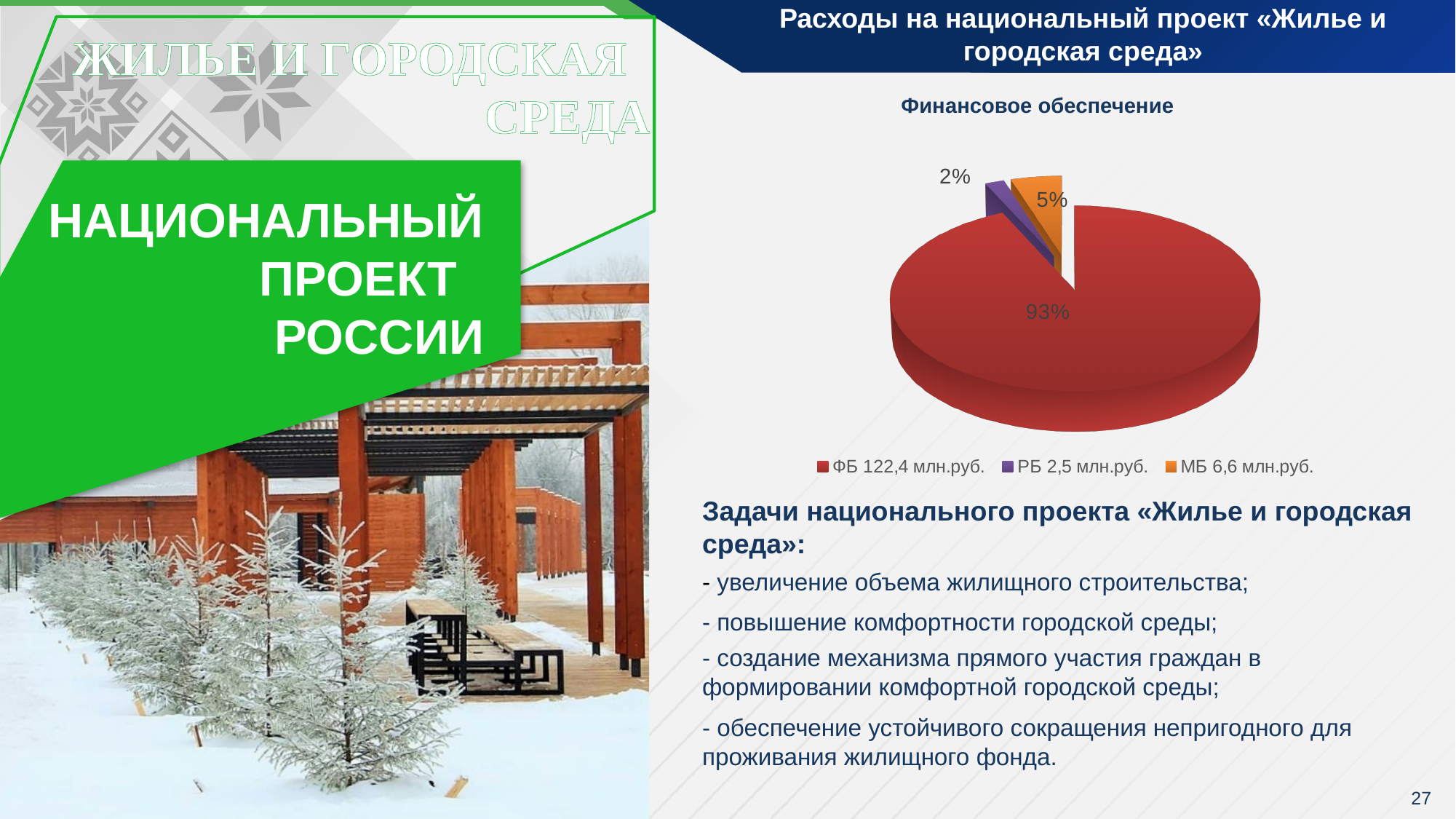
What share of the pie does ФБ (федеральный бюджет) account for? 93% What kind of chart is shown under the title «Финансовое обеспечение»? pie chart Which source has the smallest share of the pie? РБ What share of the pie does МБ account for? 5% What is the title of the chart? Финансовое обеспечение How many slices does the pie chart have? 3 What amount in млн.руб. is shown in the legend for ФБ? 122,4 млн.руб. What share of the pie does РБ account for? 2% Which is larger, the share for МБ or the share for РБ? МБ What amount in млн.руб. is shown in the legend for МБ? 6,6 млн.руб. How many entries does the legend list? 3 Which source has the largest share of the pie? ФБ